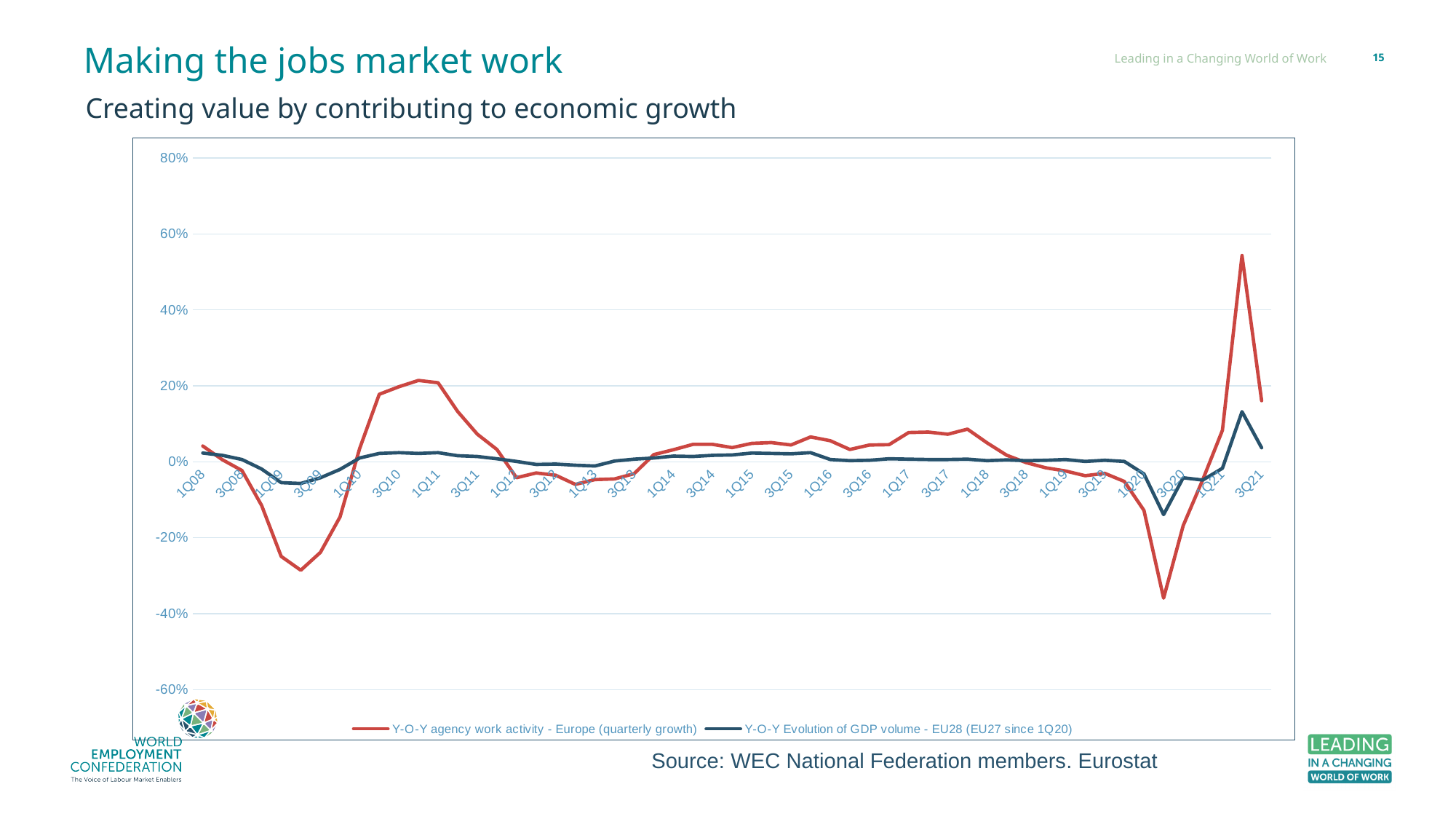
Which series is drawn in red? Y-O-Y agency work activity - Europe (quarterly growth) Is the peak value of the GDP volume line greater or less than 20%? less Is the peak value of the agency work activity line greater or less than 40%? greater Is the lowest value of the agency work activity line greater or less than -20%? less What kind of chart is shown on the slide? line chart Which series reaches the lowest value on the chart? Y-O-Y agency work activity - Europe (quarterly growth) Which series is drawn in dark blue? Y-O-Y Evolution of GDP volume - EU28 (EU27 since 1Q20) At 1Q21, which series has the larger value, agency work activity or GDP volume? agency work activity How many series does the chart legend list? 2 Which series reaches the highest value on the chart? Y-O-Y agency work activity - Europe (quarterly growth)